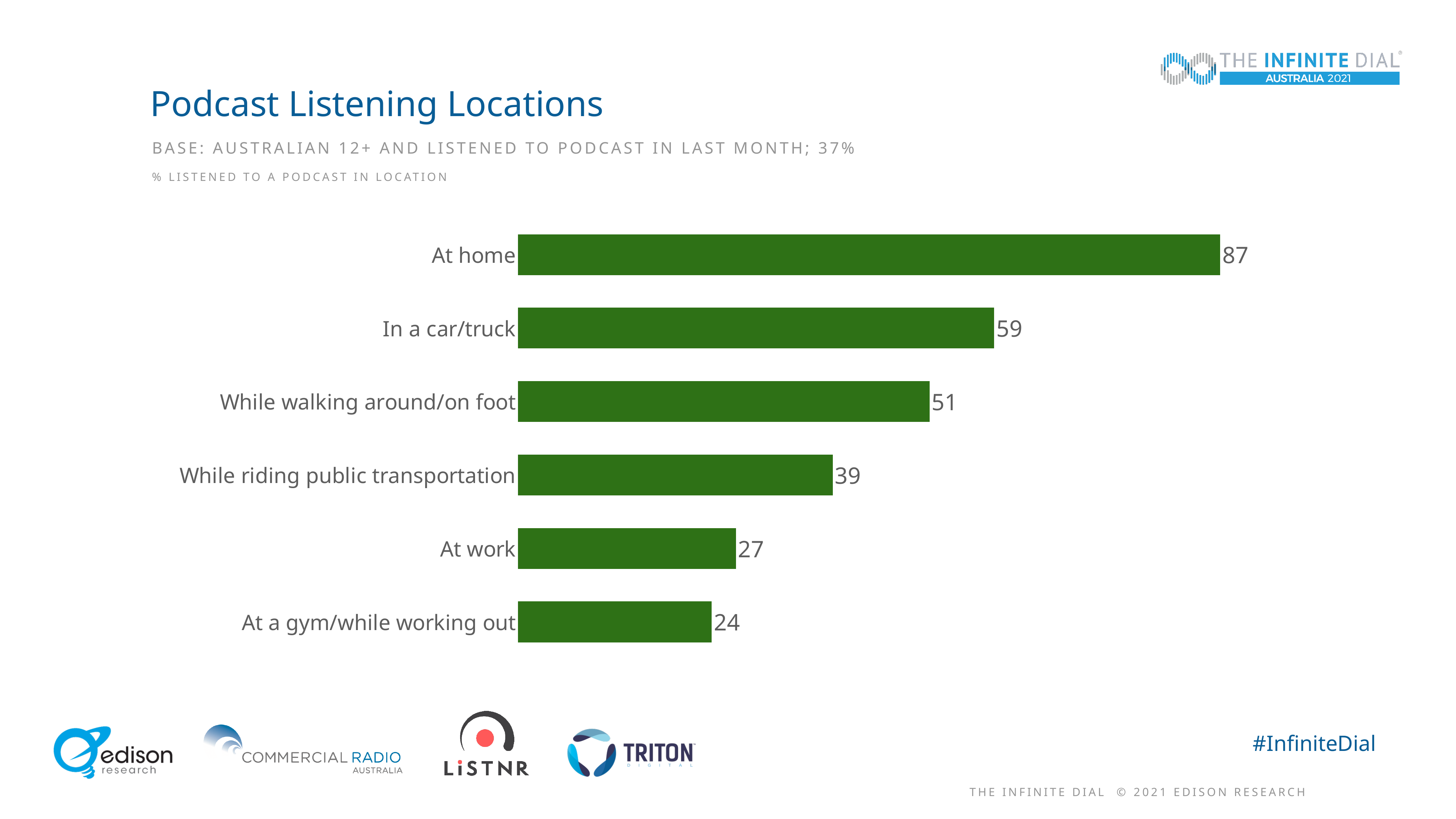
What is the difference between the values for At work and At a gym/while working out? 3 What is the difference between the values for At home and In a car/truck? 28 Which location has the lowest value? At a gym/while working out How many locations are shown in the chart? 6 What is the value for While riding public transportation? 39 What is the value for At home? 87 What kind of chart is shown on the slide? Bar chart Which location has the highest value? At home What is the value for At a gym/while working out? 24 Which is larger, the value for While walking around/on foot or the value for While riding public transportation? While walking around/on foot What is the value for In a car/truck? 59 What is the title of the chart? Podcast Listening Locations